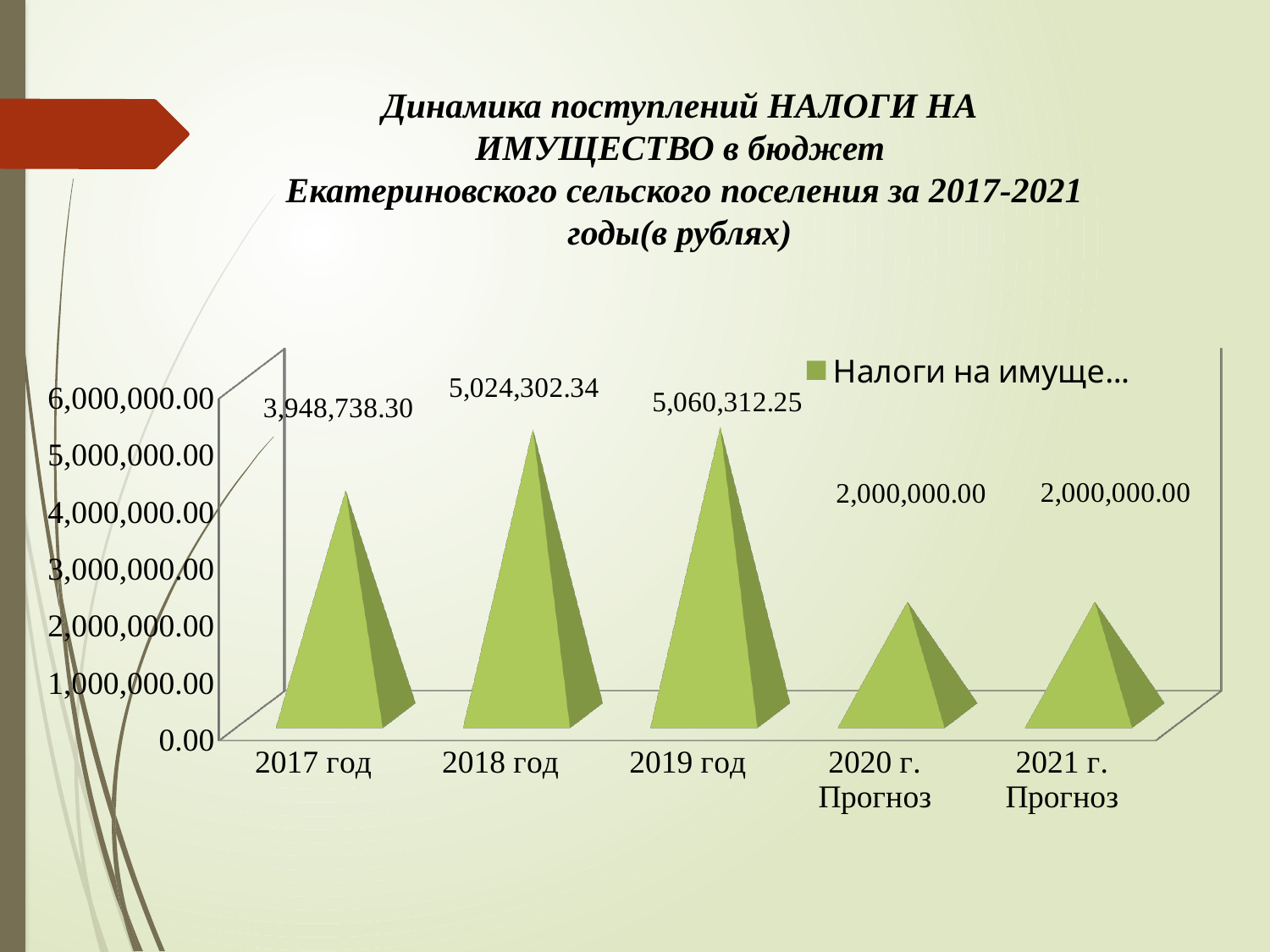
What is the difference between the values for 2019 год and 2020 г. Прогноз? 3,060,312.25 Which category has the highest value? 2019 год How many series does the legend list? 1 How many categories are shown on the x axis? 5 Is the value for 2017 год greater or less than 3,000,000.00? greater What is the difference between the values for 2018 год and 2017 год? 1,075,564.04 What is the forecast value for 2021 г. Прогноз? 2,000,000.00 Do the values rise or fall from 2017 год to 2019 год? rise What is the value for 2017 год? 3,948,738.30 Which is larger, the value for 2017 год or the value for 2020 г. Прогноз? 2017 год What is the value for 2019 год? 5,060,312.25 What is the value for 2018 год? 5,024,302.34